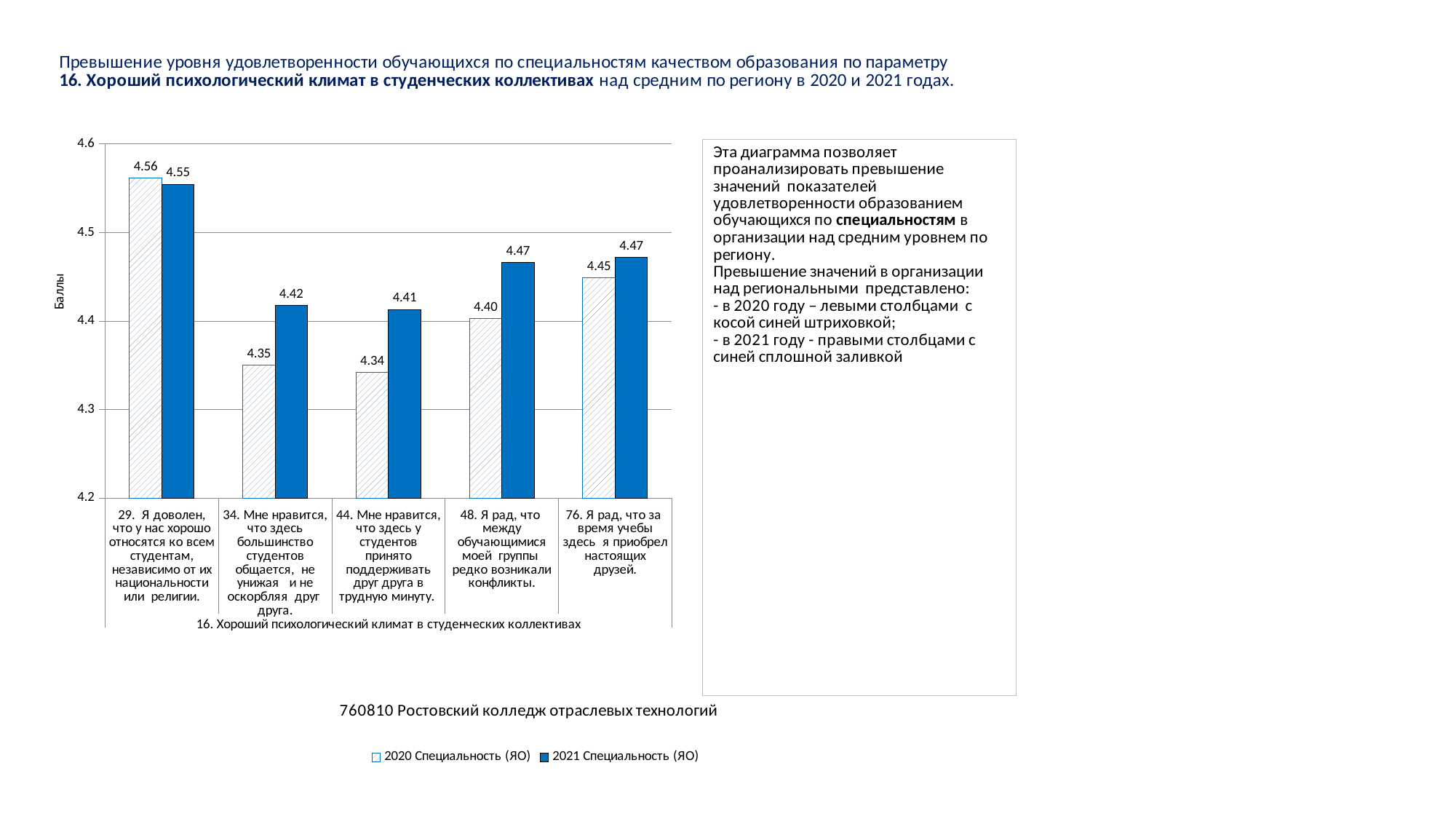
Which statement has the lowest 2021 Специальность (ЯО) value? 44. Мне нравится, что здесь у студентов принято поддерживать друг друга в трудную минуту. What is the 2020 Специальность (ЯО) value for statement 76 (Я рад, что за время учебы здесь я приобрел настоящих друзей)? 4.45 How many categories (statements) are shown on the x axis? 5 For statement 29, which series has the larger value, 2020 Специальность (ЯО) or 2021 Специальность (ЯО)? 2020 Специальность (ЯО) Which statement has the highest 2020 Специальность (ЯО) value? 29. Я доволен, что у нас хорошо относятся ко всем студентам, независимо от их национальности или религии. What is the 2020 Специальность (ЯО) value for statement 44 (Мне нравится, что здесь у студентов принято поддерживать друг друга в трудную минуту)? 4.34 What is the label of the vertical axis? Баллы What is the 2021 Специальность (ЯО) value for statement 34 (Мне нравится, что здесь большинство студентов общается, не унижая и не оскорбляя друг друга)? 4.42 Is the 2020 Специальность (ЯО) value for statement 34 greater or less than 4.4? less What type of chart is shown on the slide? bar chart How many series does the legend list? 2 What is the difference between the 2021 and 2020 values for statement 48 (Я рад, что между обучающимися моей группы редко возникали конфликты)? 0.07